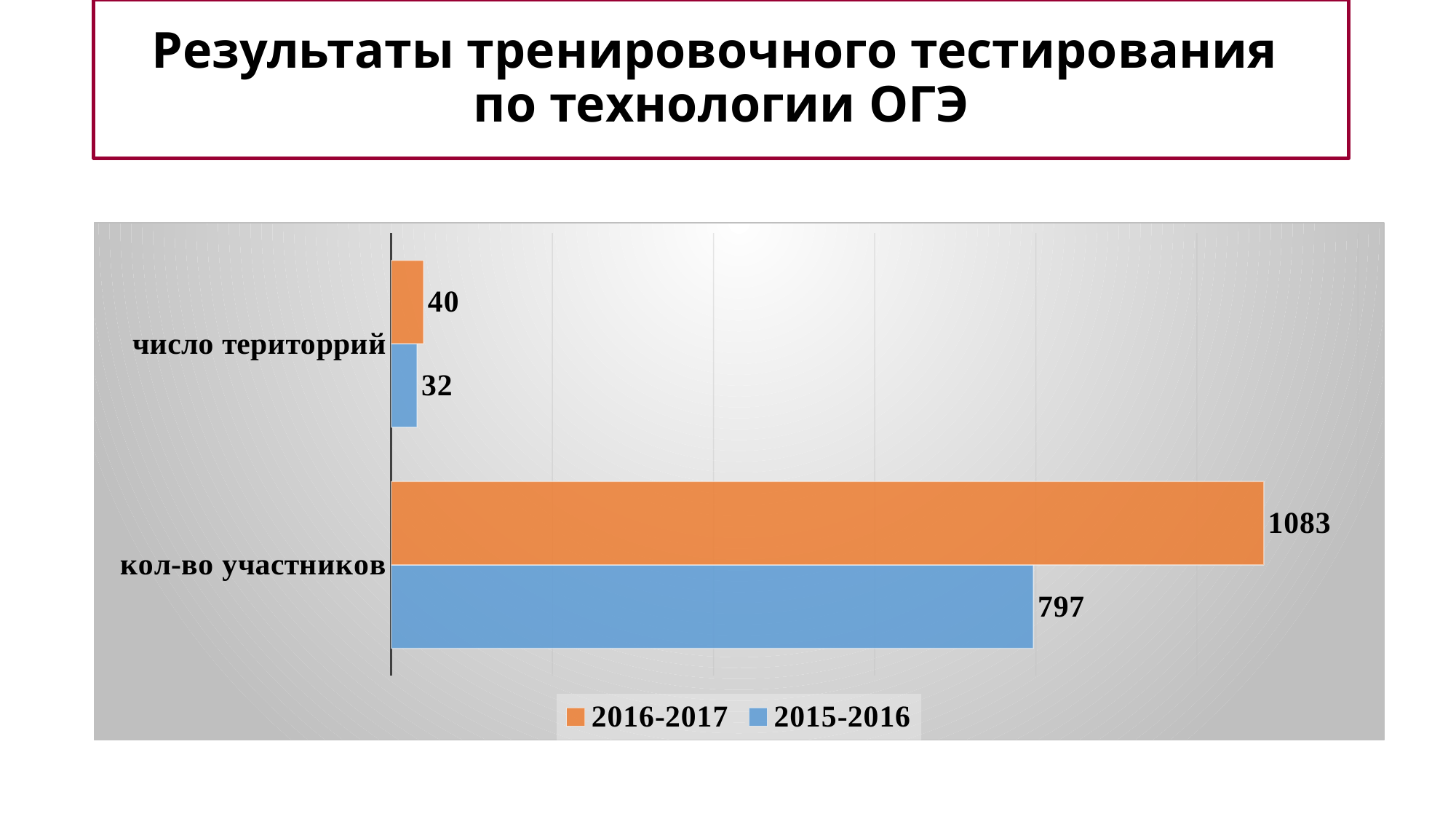
What is the value for 'число територрий' in the 2015-2016 series? 32 Which series has the larger value for 'число територрий', 2016-2017 or 2015-2016? 2016-2017 What is the value for 'кол-во участников' in the 2015-2016 series? 797 Which colour represents the 2015-2016 series in the legend? Blue What is the difference between the 2016-2017 and 2015-2016 values for 'кол-во участников'? 286 What is the value for 'кол-во участников' in the 2016-2017 series? 1083 How many series does the legend list? 2 What kind of chart is shown on the slide? Bar chart Which series has the larger value for 'кол-во участников', 2016-2017 or 2015-2016? 2016-2017 How many categories are shown on the chart? 2 What is the value for 'число територрий' in the 2016-2017 series? 40 What is the difference between the 2016-2017 and 2015-2016 values for 'число територрий'? 8